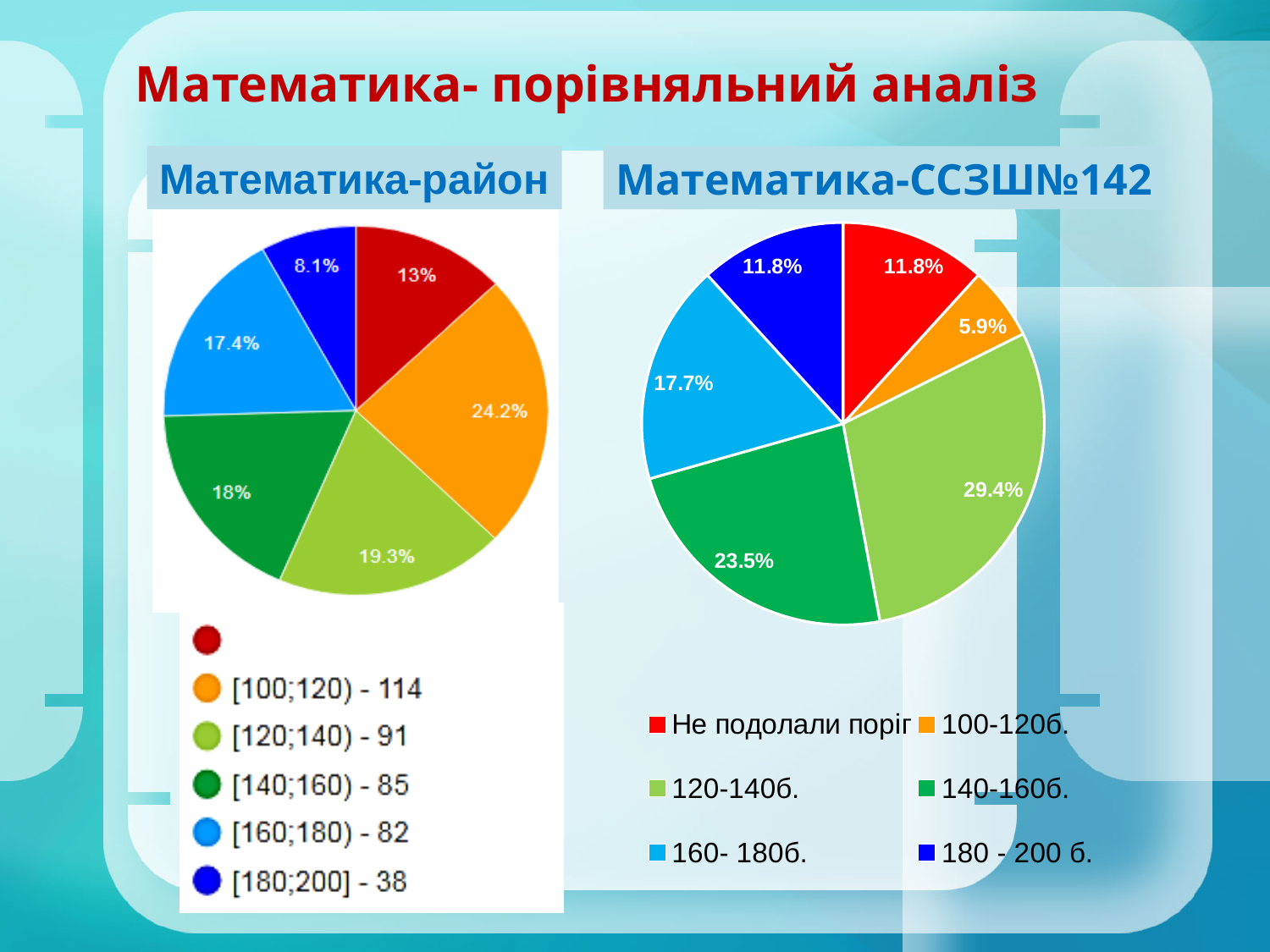
In the "Математика-ССЗШ№142" pie chart, what share does the 100-120б. category have? 5.9% In the "Математика-район" pie chart, what share does the [180;200] category have? 8.1% In the "Математика-район" pie chart, which category has the smallest slice? [180;200] Which is larger: the 160-180 share in the "Математика-район" chart or in the "Математика-ССЗШ№142" chart? Математика-ССЗШ№142 In the "Математика-ССЗШ№142" pie chart, what is the difference between the 120-140б. share and the 140-160б. share? 5.9% In the "Математика-ССЗШ№142" pie chart, what share does the 120-140б. category have? 29.4% What type of chart is used for "Математика-ССЗШ№142"? Pie chart In the "Математика-ССЗШ№142" pie chart, which category has the smallest slice? 100-120б. In the "Математика-район" pie chart, which category has the largest slice? [100;120) In the "Математика-район" chart legend, how many students are listed for the [120;140) category? 91 In the "Математика-район" pie chart, what share does the [100;120) category have? 24.2% In the "Математика-ССЗШ№142" pie chart, which category has the largest slice? 120-140б.